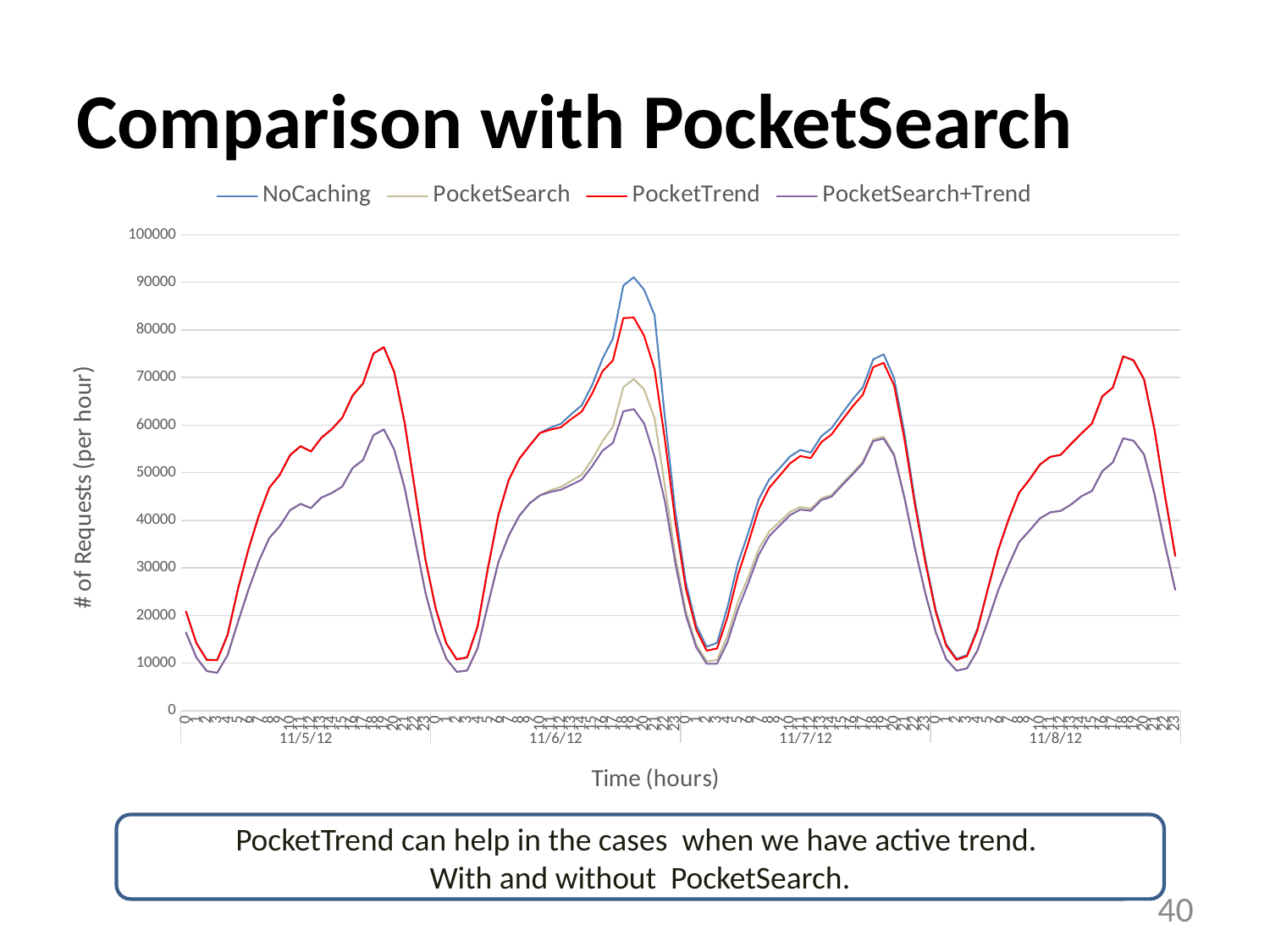
Is the lowest value of PocketSearch+Trend on 11/7/12 greater or less than 20000? less Does the PocketTrend series rise or fall between hour 3 and hour 18 on 11/5/12? rise Is the peak value of NoCaching on 11/6/12 greater or less than 80000? greater Is the peak value of PocketTrend on 11/8/12 greater or less than 70000? greater How many dates are labelled along the x axis? 4 How many series does the legend list? 4 What kind of chart is shown on the slide? line chart On 11/6/12, which series peaks higher, PocketTrend or PocketSearch? PocketTrend On which date does the NoCaching series reach its highest peak? 11/6/12 What are the four series named in the legend? NoCaching, PocketSearch, PocketTrend, PocketSearch+Trend What is the title of the vertical axis? # of Requests (per hour)